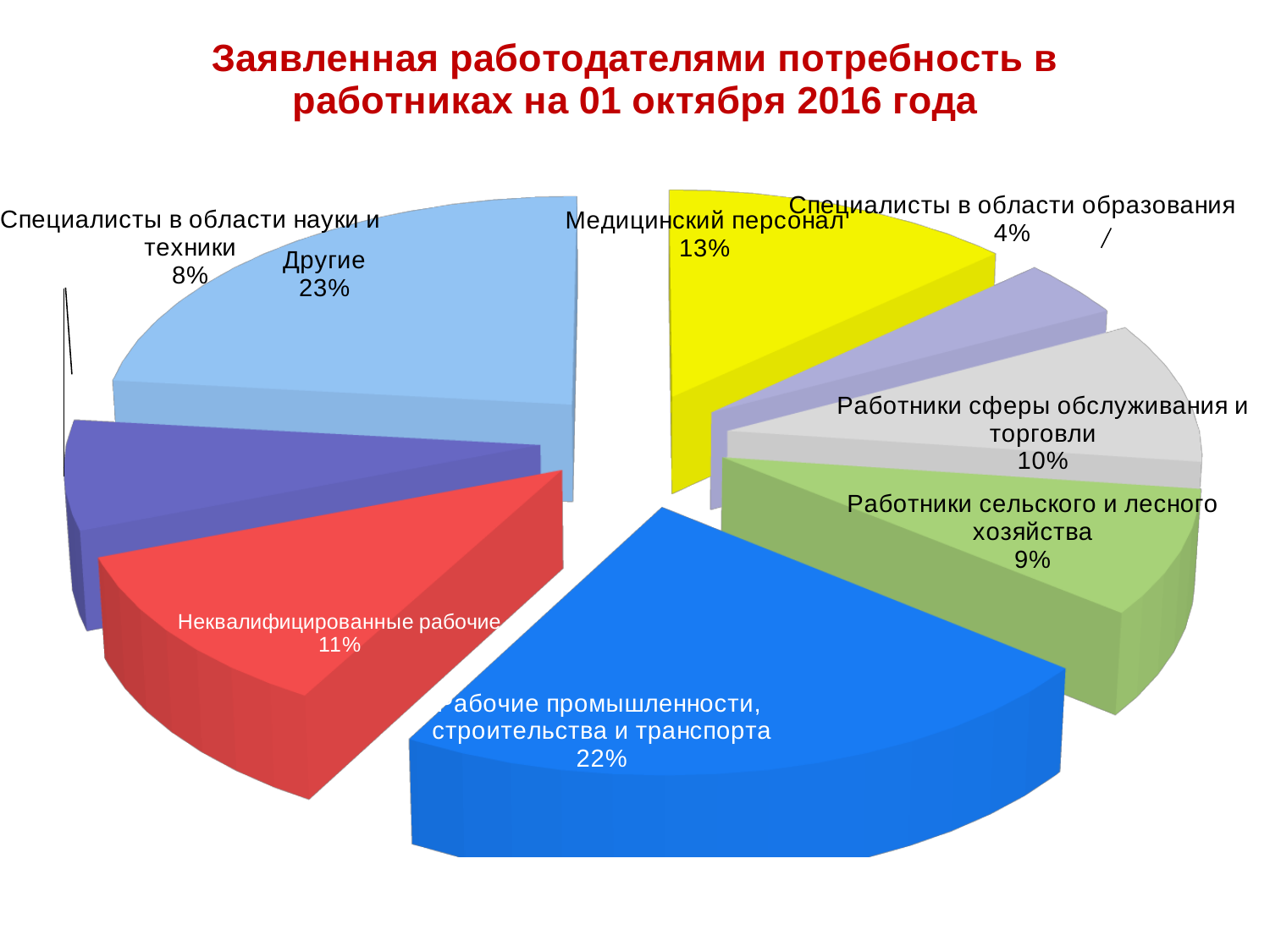
What is the value for "Работники сельского и лесного хозяйства"? 9% Which category has the largest share of the pie? Другие Which category has the smallest share of the pie? Специалисты в области образования What is the title of the chart? Заявленная работодателями потребность в работниках на 01 октября 2016 года What kind of chart is shown on the slide? Pie chart What is the difference between the shares of "Другие" and "Рабочие промышленности, строительства и транспорта"? 1% Which is larger: the share for "Работники сферы обслуживания и торговли" or for "Медицинский персонал"? Медицинский персонал What is the value for "Рабочие промышленности, строительства и транспорта"? 22% What is the value for "Медицинский персонал"? 13% What is the difference between the shares of "Неквалифицированные рабочие" and "Специалисты в области науки и техники"? 3% What share of the pie is labelled "Другие"? 23% How many slices does the pie chart have? 8